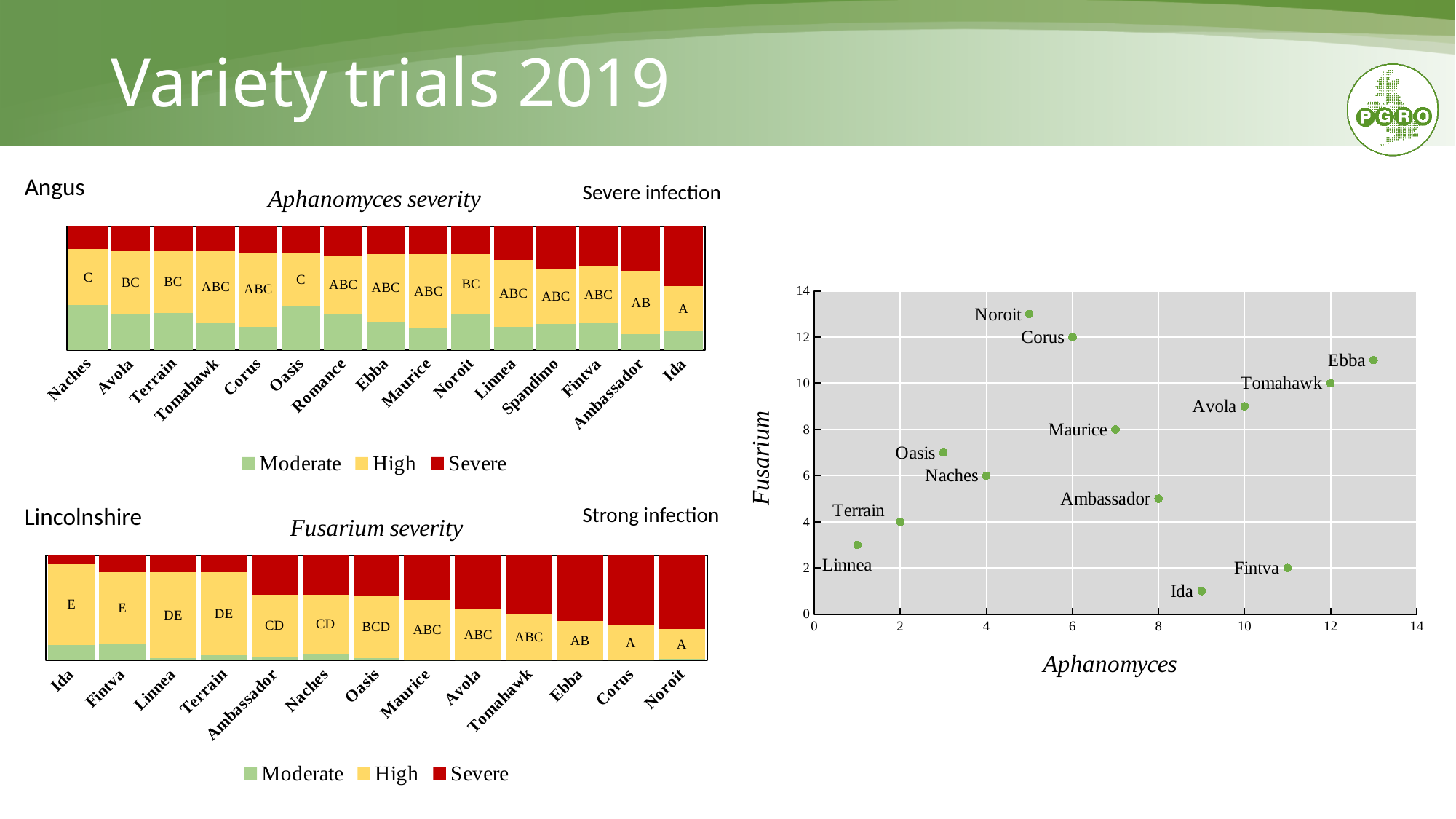
In the scatter chart on the right, which variety has the lowest Aphanomyces value? Linnea In the scatter chart on the right, which variety has the highest Fusarium value? Noroit How many varieties are shown on the x axis of the 'Fusarium severity' chart? 13 In the 'Fusarium severity' chart, what letter label is printed on the bar for Ambassador? CD What kind of chart is the chart titled 'Aphanomyces severity'? stacked bar chart In the scatter chart on the right, what is the difference between the Fusarium values of Corus and Naches? 6 In the scatter chart on the right, what is the Aphanomyces value for Terrain? 2 In the scatter chart on the right, what is the Fusarium value for Corus? 12 In the scatter chart on the right, is the Fusarium value for Ebba greater or less than 10? greater How many varieties are shown on the x axis of the 'Aphanomyces severity' chart? 15 In the scatter chart on the right, what is the Aphanomyces value for Tomahawk? 12 How many series does the legend of the 'Fusarium severity' chart list? 3